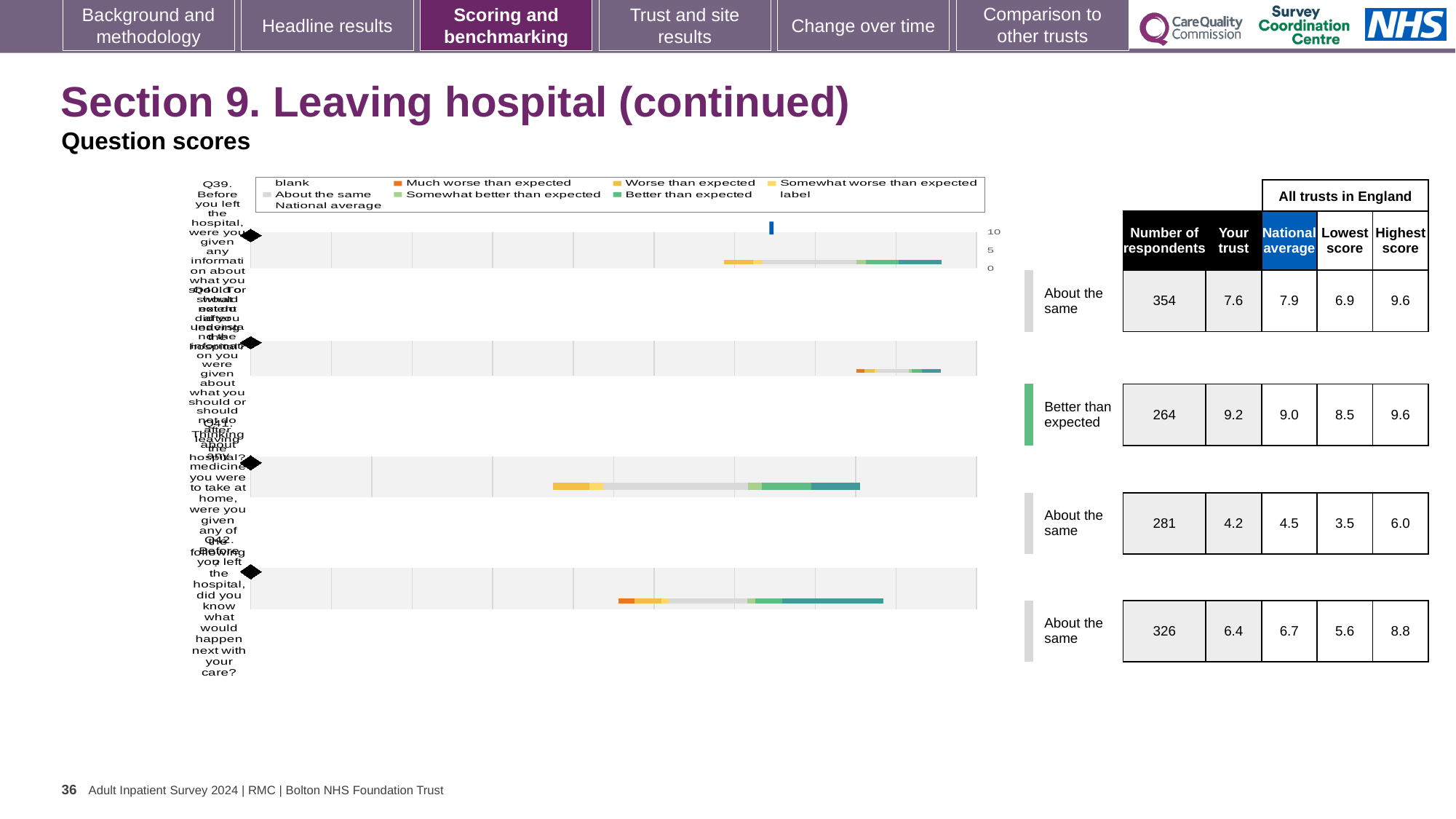
What is the 'Your trust' score for Q40? 9.2 What is the difference between the national average and the 'Your trust' score for Q39? 0.3 Which question is rated 'Better than expected'? Q40 How many respondents answered Q42? 326 What type of chart is used to show the question scores for Section 9? Bar chart Which question has the highest 'Your trust' score? Q40 Which question has the lowest 'Your trust' score? Q41 What is the difference between the highest and lowest scores for Q42? 3.2 For Q40, which is larger: the 'Your trust' score or the national average? Your trust (9.2) How many of the questions are rated 'About the same'? 3 What is the highest score among all trusts in England for Q41? 6.0 How many questions (bars) are shown in the chart? 4